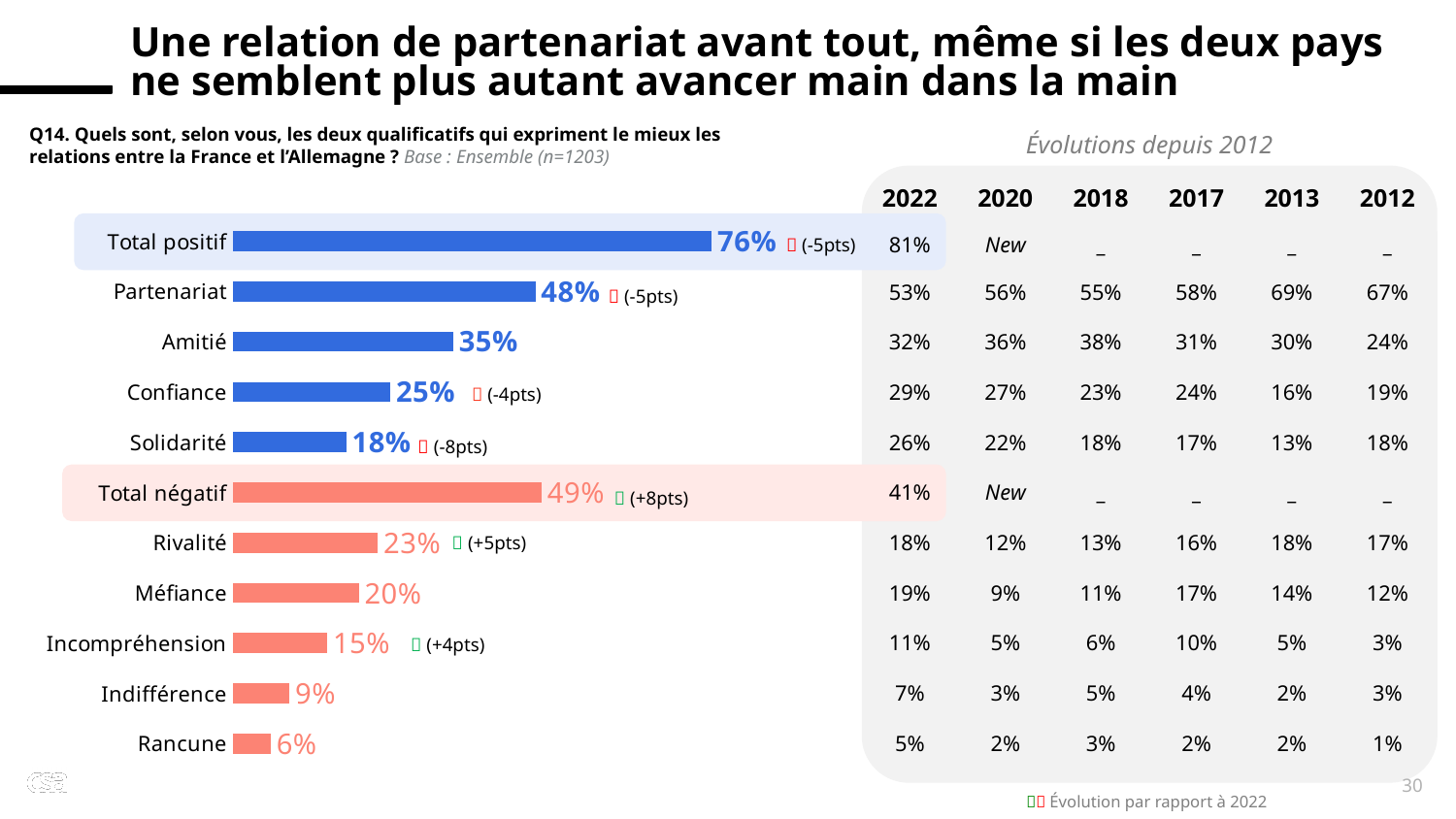
Which category has the highest value in the bar chart? Total positif What value is shown for Amitié in the bar chart? 35% Which is larger in the bar chart, Méfiance or Solidarité? Méfiance What is the difference between the values for Total positif and Total négatif in the bar chart? 27 points What is the difference between the values for Confiance and Solidarité in the bar chart? 7 points What value is shown for Incompréhension in the bar chart? 15% What change compared to 2022 is indicated next to the Solidarité bar? -8pts How many categories are shown in the bar chart? 11 What value is shown for Partenariat in the bar chart? 48% What kind of chart is shown on the slide? Bar chart Which category has the lowest value in the bar chart? Rancune What value is shown for Rivalité in the bar chart? 23%